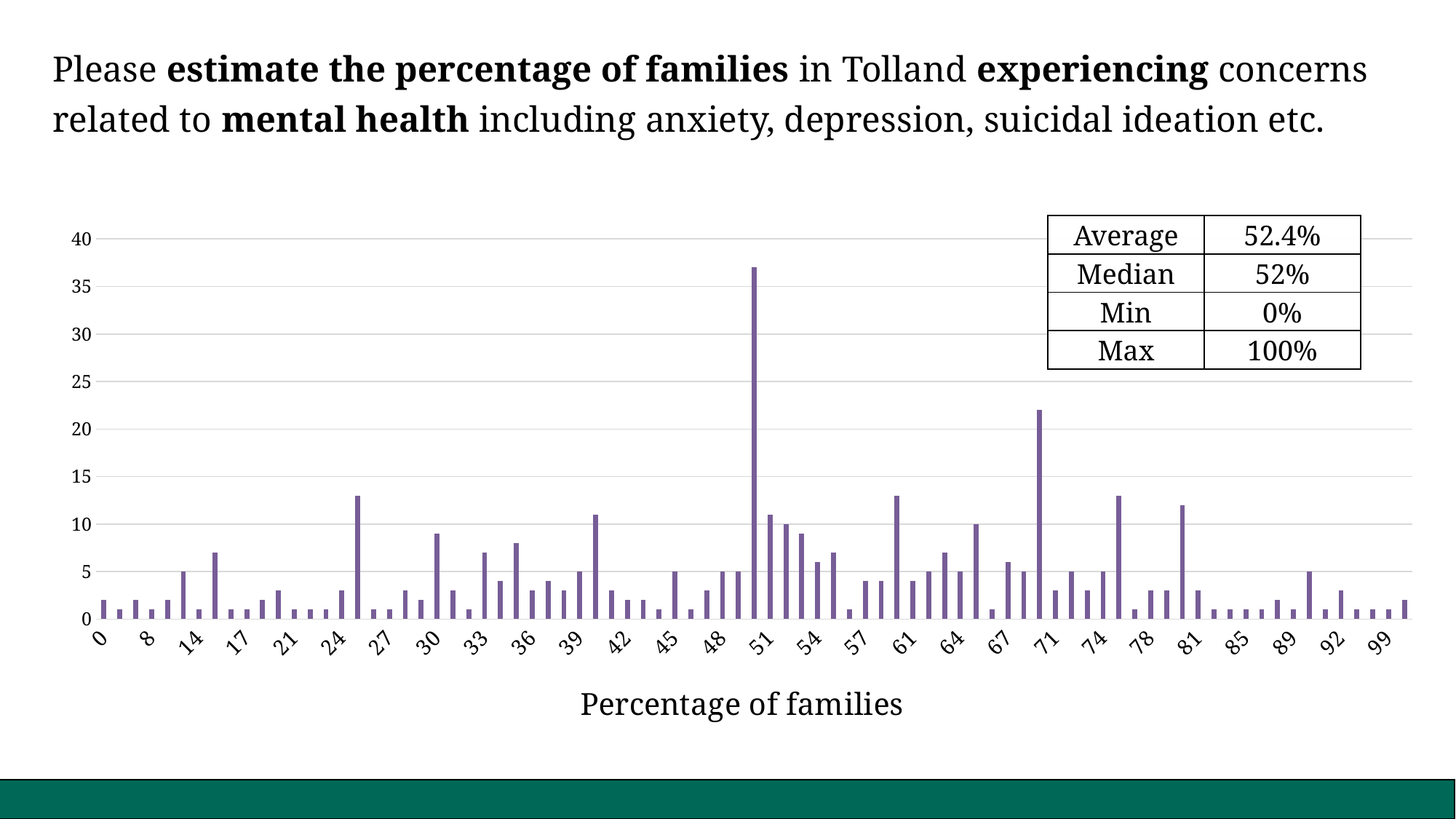
What is the Median value shown in the table on the chart? 52% What kind of chart is shown on the slide? bar chart What is the Min value shown in the table on the chart? 0% Is the value for 0 greater or less than 5? less What colour are the bars in the chart? purple Is the value for 99 greater or less than 5? less Is the tallest bar in the chart greater or less than 35? greater What is the Average value shown in the table on the chart? 52.4% What is the title of the x axis of the chart? Percentage of families What is the Max value shown in the table on the chart? 100%